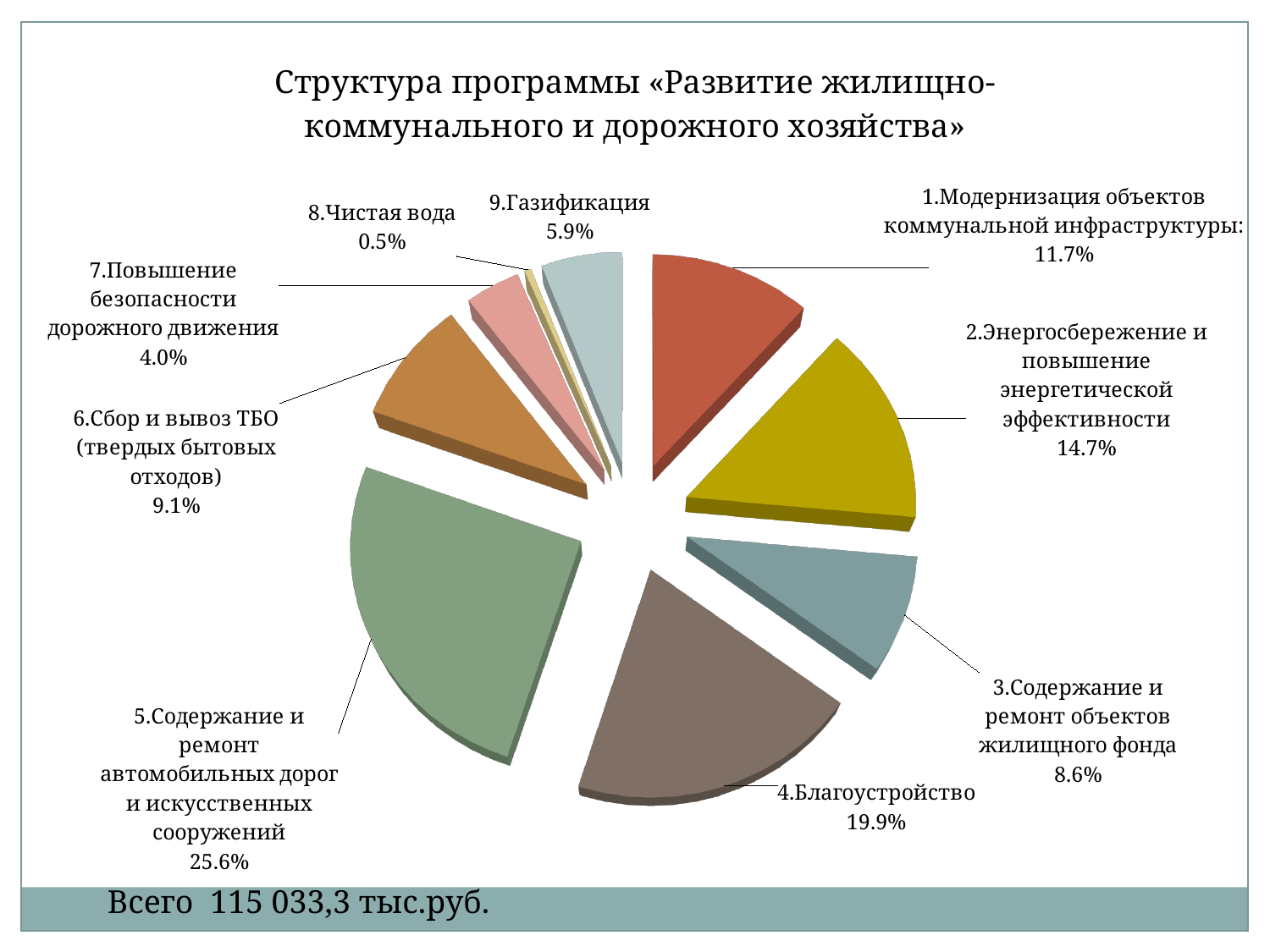
What share of the pie does "4.Благоустройство" have? 19.9% What is the value shown for "6.Сбор и вывоз ТБО (твердых бытовых отходов)"? 9.1% What total amount is stated at the bottom of the slide? 115 033,3 тыс.руб. What is the difference in percentage points between "5.Содержание и ремонт автомобильных дорог и искусственных сооружений" and "4.Благоустройство"? 5.7 What is the value shown for "9.Газификация"? 5.9% Which category has the smallest share of the pie? 8.Чистая вода How many slices does the pie chart have? 9 Which is larger: the share for "1.Модернизация объектов коммунальной инфраструктуры" or for "3.Содержание и ремонт объектов жилищного фонда"? 1.Модернизация объектов коммунальной инфраструктуры What kind of chart is shown on the slide? Pie chart Which category has the largest share of the pie? 5.Содержание и ремонт автомобильных дорог и искусственных сооружений What is the difference in percentage points between "7.Повышение безопасности дорожного движения" and "8.Чистая вода"? 3.5 What is the value shown for "2.Энергосбережение и повышение энергетической эффективности"? 14.7%